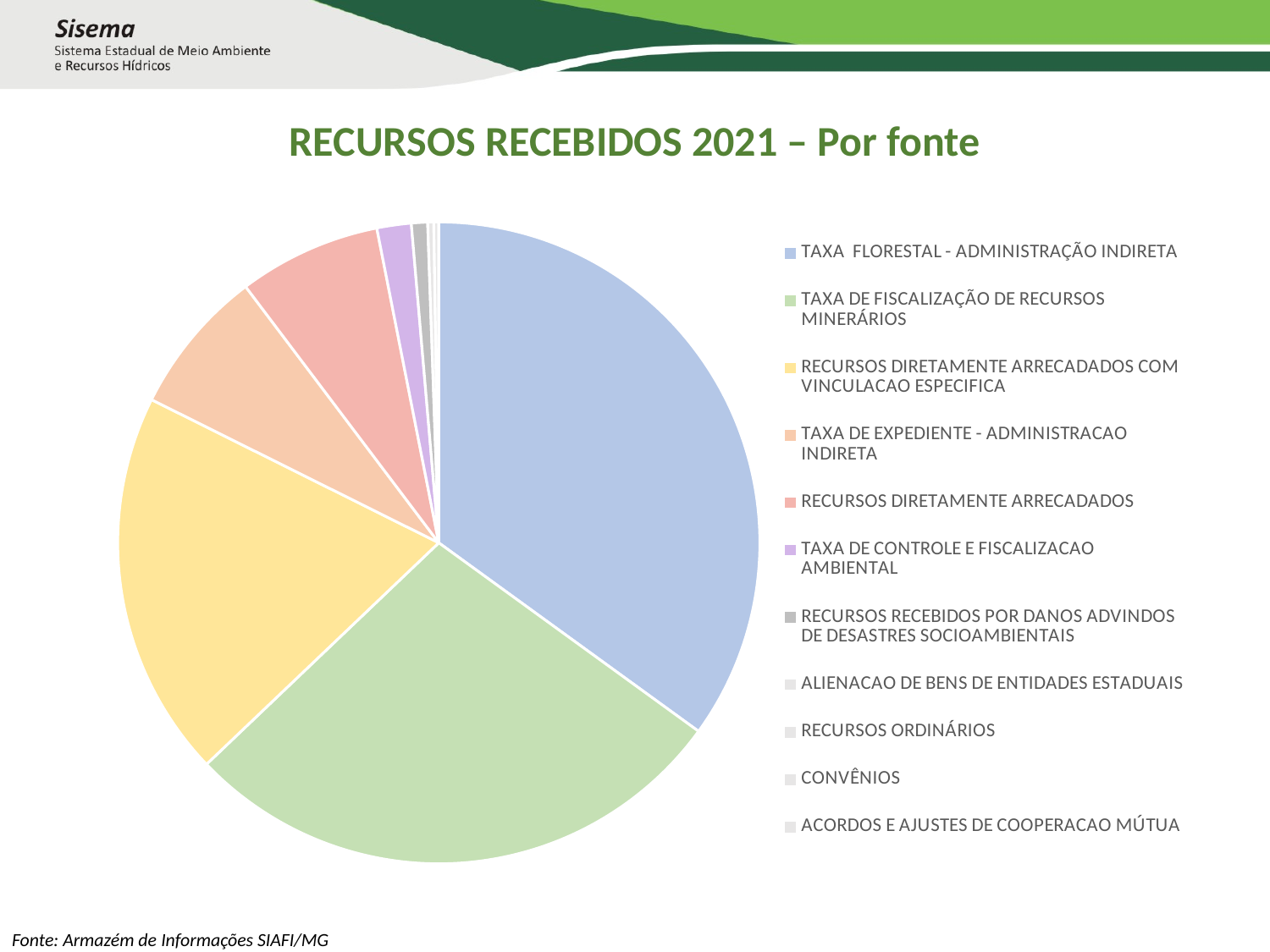
Which slice is larger: RECURSOS DIRETAMENTE ARRECADADOS or TAXA DE CONTROLE E FISCALIZACAO AMBIENTAL? RECURSOS DIRETAMENTE ARRECADADOS What source is cited for the chart data at the bottom of the slide? Armazém de Informações SIAFI/MG Which slice is larger: RECURSOS DIRETAMENTE ARRECADADOS COM VINCULACAO ESPECIFICA or TAXA DE EXPEDIENTE - ADMINISTRACAO INDIRETA? RECURSOS DIRETAMENTE ARRECADADOS COM VINCULACAO ESPECIFICA Which slice is larger: TAXA DE FISCALIZAÇÃO DE RECURSOS MINERÁRIOS or RECURSOS DIRETAMENTE ARRECADADOS COM VINCULACAO ESPECIFICA? TAXA DE FISCALIZAÇÃO DE RECURSOS MINERÁRIOS How many categories does the legend of the pie chart list? 11 What is the title of the chart on the slide? RECURSOS RECEBIDOS 2021 – Por fonte Which category has the largest slice of the pie chart? TAXA FLORESTAL - ADMINISTRAÇÃO INDIRETA What kind of chart is shown on the slide? Pie chart